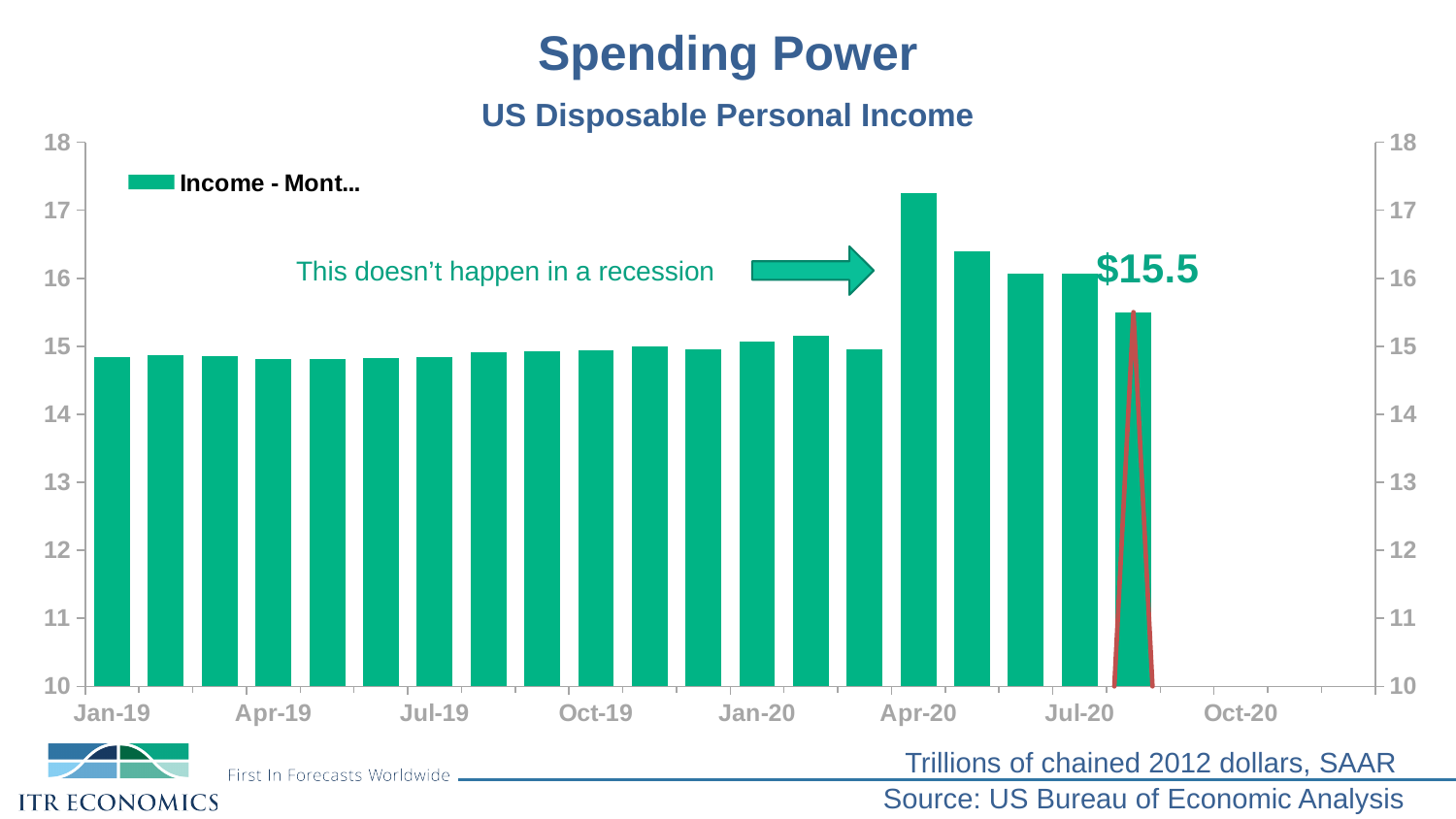
Is the value for Jan-19 greater or less than 15? less Do the values rise or fall from Apr-20 to the last bar on the chart? Fall Is the value for Apr-20 greater or less than 17? greater What value is printed as a data label on the last bar of the chart? $15.5 What kind of chart is shown on the slide? Bar chart How many series does the legend list? 1 Which month has the highest bar in the chart? Apr-20 What is the chart's title? US Disposable Personal Income In what units are the values on the chart expressed, according to the note at the bottom of the slide? Trillions of chained 2012 dollars, SAAR Which is larger, the value for Apr-20 or the value for Jan-20? Apr-20 Which is larger, the value for May-20 or the value for Jul-20? May-20